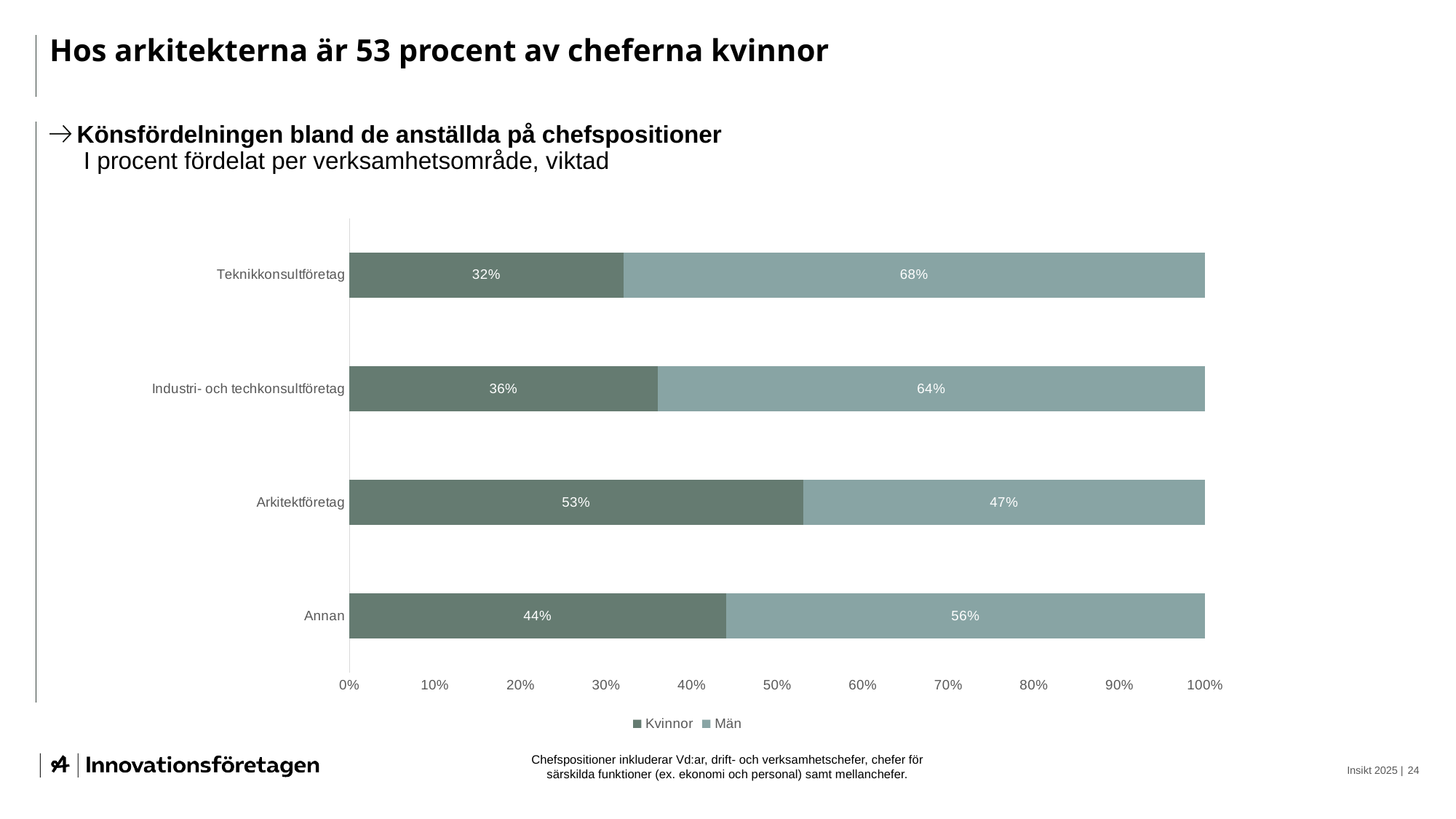
Which category has the highest Kvinnor share? Arkitektföretag What is the total of the stacked bar for Industri- och techkonsultföretag? 100% What is the Kvinnor value for Industri- och techkonsultföretag? 36% What is the Män value for Teknikkonsultföretag? 68% Which category has the lowest Kvinnor share? Teknikkonsultföretag What is the difference between the Män and Kvinnor values for Teknikkonsultföretag? 36 percentage points Which is larger for Annan, the Kvinnor value or the Män value? Män What kind of chart is shown on the slide? Stacked bar chart How many categories are shown on the chart? 4 What is the Kvinnor value for Arkitektföretag? 53% What is the Män value for Annan? 56% How many series does the legend list? 2